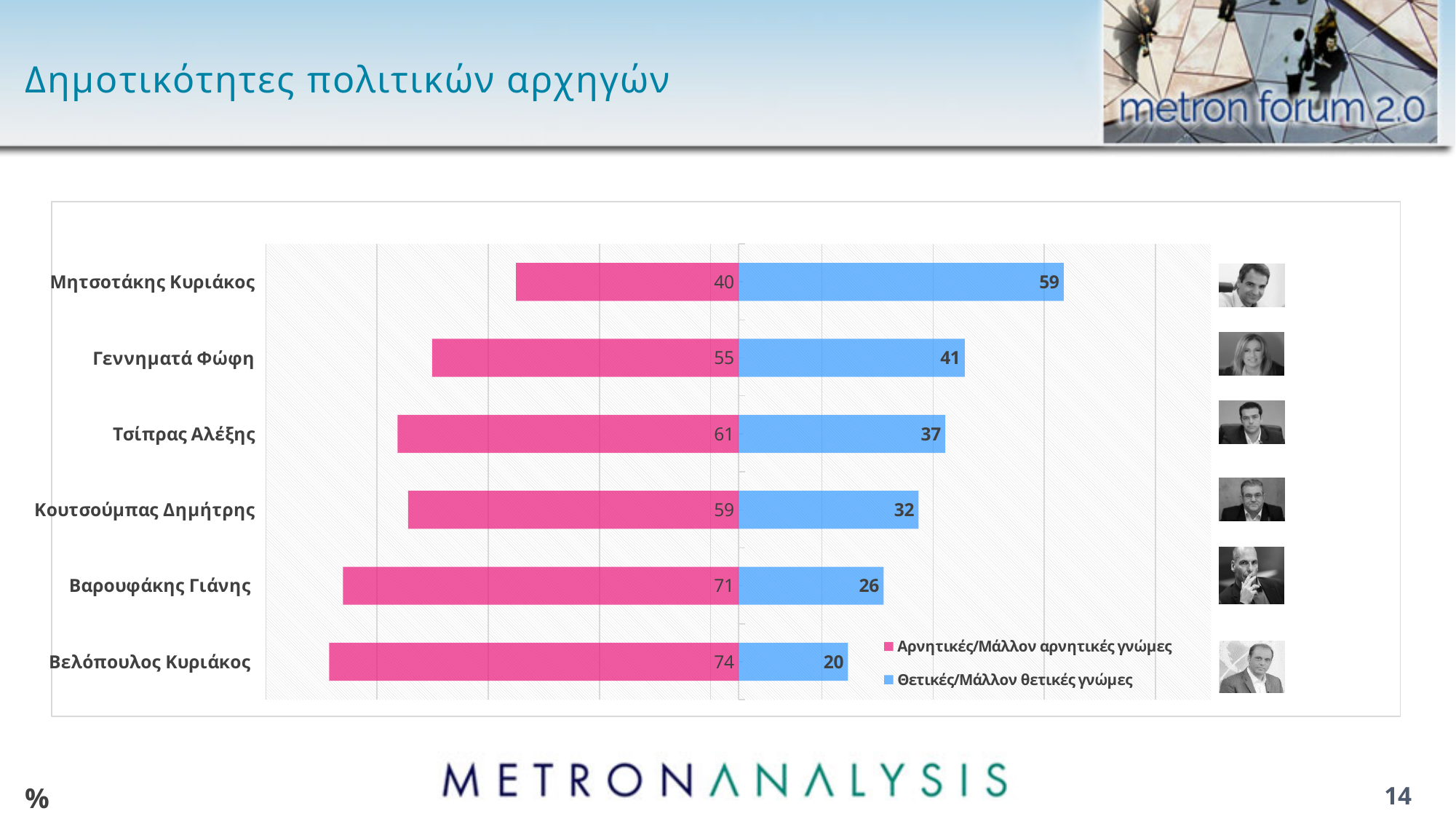
What is the difference between the Θετικές/Μάλλον θετικές γνώμες values for Γεννηματά Φώφη and Βαρουφάκης Γιάνης? 15 Which leader has the highest value for Θετικές/Μάλλον θετικές γνώμες? Μητσοτάκης Κυριάκος What is the value of Θετικές/Μάλλον θετικές γνώμες for Μητσοτάκης Κυριάκος? 59 What is the value of Αρνητικές/Μάλλον αρνητικές γνώμες for Βελόπουλος Κυριάκος? 74 Which leader has the lowest value for Αρνητικές/Μάλλον αρνητικές γνώμες? Μητσοτάκης Κυριάκος Which is larger: the Αρνητικές/Μάλλον αρνητικές γνώμες value for Κουτσούμπας Δημήτρης or for Γεννηματά Φώφη? Κουτσούμπας Δημήτρης What is the total of the two values shown for Βαρουφάκης Γιάνης? 97 What kind of chart is shown on the slide? Bar chart Which colour represents Θετικές/Μάλλον θετικές γνώμες in the chart? Blue What is the value of Αρνητικές/Μάλλον αρνητικές γνώμες for Τσίπρας Αλέξης? 61 How many series does the legend list? 2 How many leaders are shown in the chart? 6